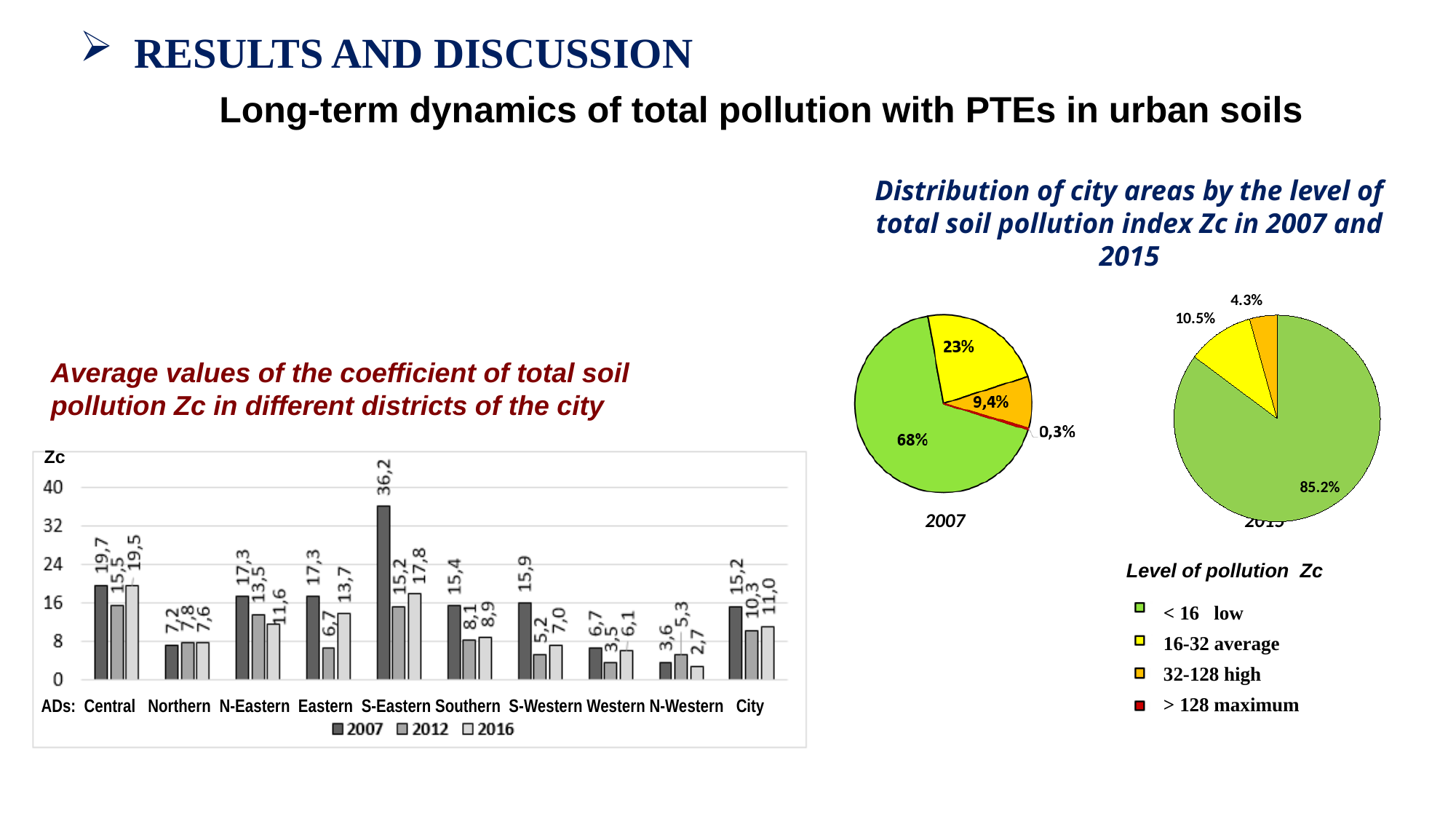
What type of chart is used to show the average values of Zc in different districts of the city? bar chart In the 2007 pie chart, what share of city areas has the maximum level of pollution (> 128)? 0,3% In the 2015 pie chart of the distribution of city areas by level of total soil pollution index Zc, what share of areas has an average level (16-32)? 10.5% In the bar chart on the left, how many series does the legend list? 3 In the bar chart on the left, which district has the highest 2007 value? S-Eastern In the bar chart on the left, how many district categories (including City) are shown on the x axis? 10 In the bar chart on the left, what is the 2016 value for the Central district? 19,5 In the bar chart on the left, which is larger for the Northern district: the 2012 value or the 2016 value? 2012 In the bar chart on the left, what is the difference between the 2007 and 2012 values for the Eastern district? 10,6 In the 2007 pie chart of the distribution of city areas by level of total soil pollution index Zc, what share of areas has a low level (< 16)? 68% In the bar chart on the left, which district has the lowest 2016 value? N-Western In the bar chart 'Average values of the coefficient of total soil pollution Zc in different districts of the city', what is the 2007 value for the S-Eastern district? 36,2